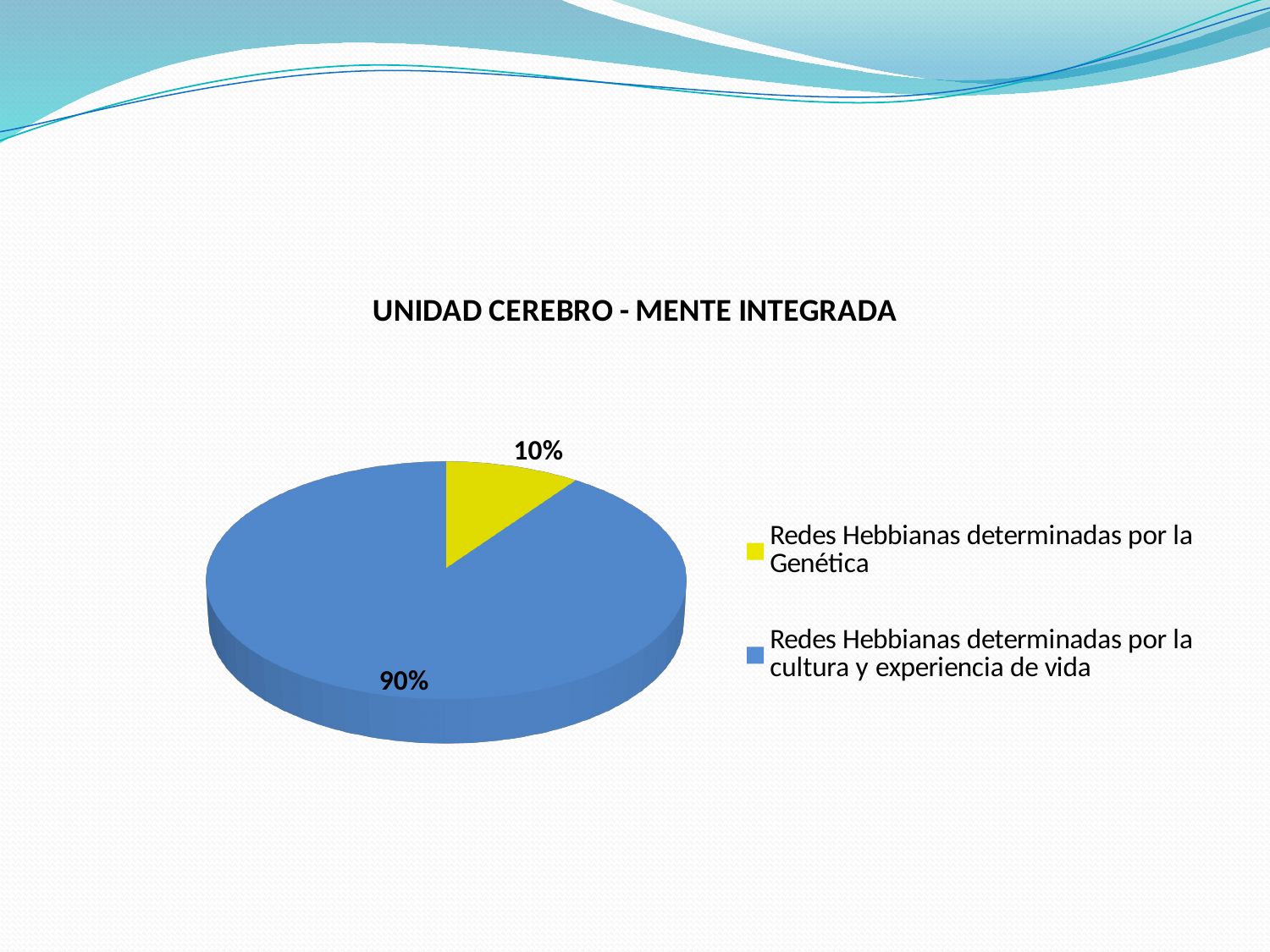
How many entries does the legend list? 2 Which category has the largest slice of the pie? Redes Hebbianas determinadas por la cultura y experiencia de vida What is the difference in percentage points between the two slices of the pie? 80% What kind of chart is shown on the slide? Pie chart What share of the pie is labelled for 'Redes Hebbianas determinadas por la Genética'? 10% What share of the pie is labelled for 'Redes Hebbianas determinadas por la cultura y experiencia de vida'? 90% Which is larger: the slice for 'Redes Hebbianas determinadas por la Genética' or the slice for 'Redes Hebbianas determinadas por la cultura y experiencia de vida'? Redes Hebbianas determinadas por la cultura y experiencia de vida How many slices does the pie chart have? 2 Which category has the smallest slice of the pie? Redes Hebbianas determinadas por la Genética What is the title of the chart? UNIDAD CEREBRO - MENTE INTEGRADA What colour is the slice for 'Redes Hebbianas determinadas por la Genética'? Yellow